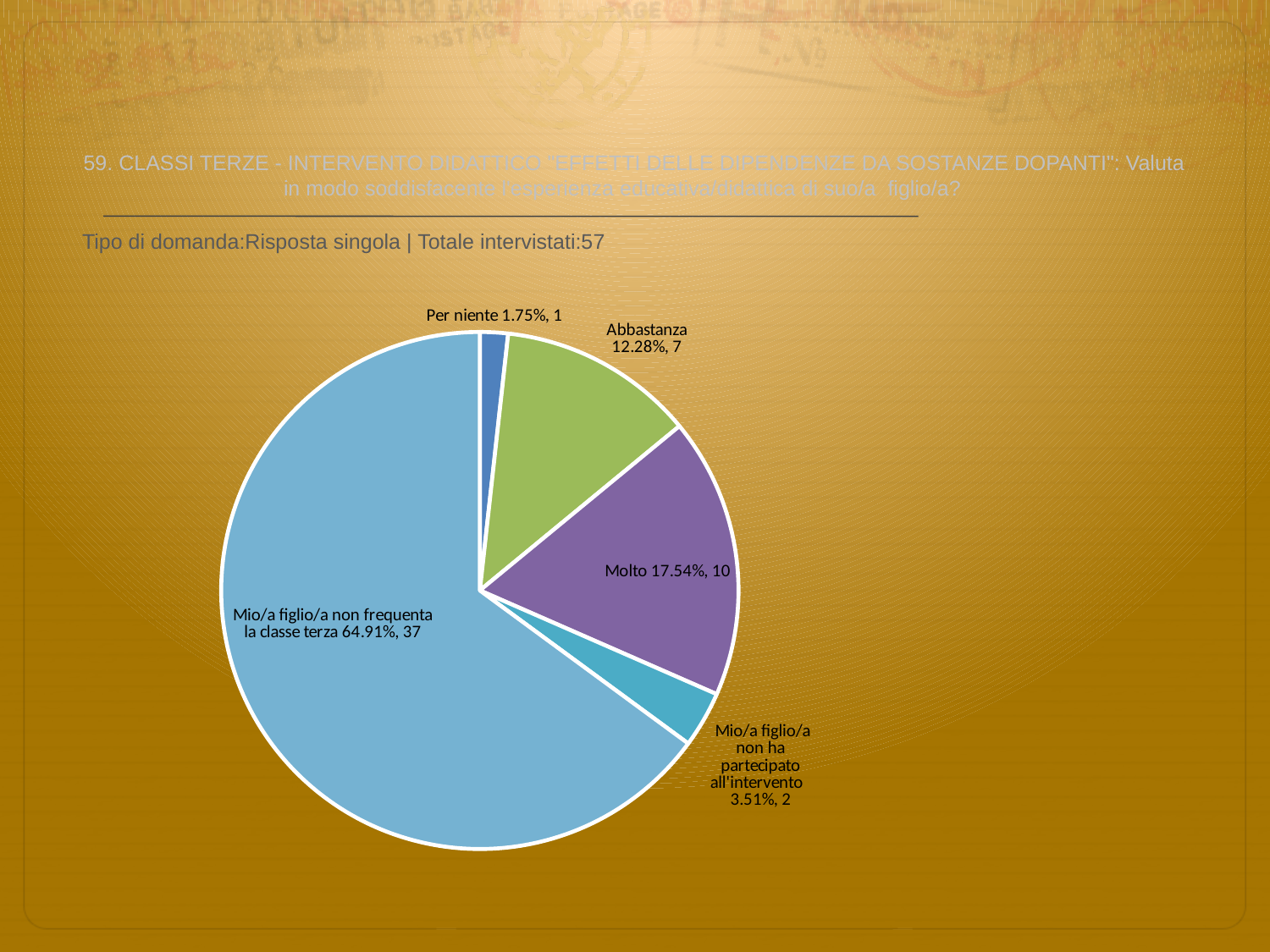
What percentage share does the "Mio/a figlio/a non frequenta la classe terza" slice have? 64.91% How many respondents answered "Mio/a figlio/a non ha partecipato all'intervento"? 2 What kind of chart is shown on the slide? Pie chart What is the difference between the counts for "Molto" and "Abbastanza"? 3 How many slices does the pie chart have? 5 What is the count shown for "Per niente"? 1 Which category has the smallest slice of the pie? Per niente How many respondents answered "Abbastanza"? 7 What percentage share does the "Molto" slice have? 17.54% What is the total number of respondents (Totale intervistati) stated on the slide? 57 Which is larger, the count for "Molto" or the count for "Abbastanza"? Molto Which category has the largest slice of the pie? Mio/a figlio/a non frequenta la classe terza